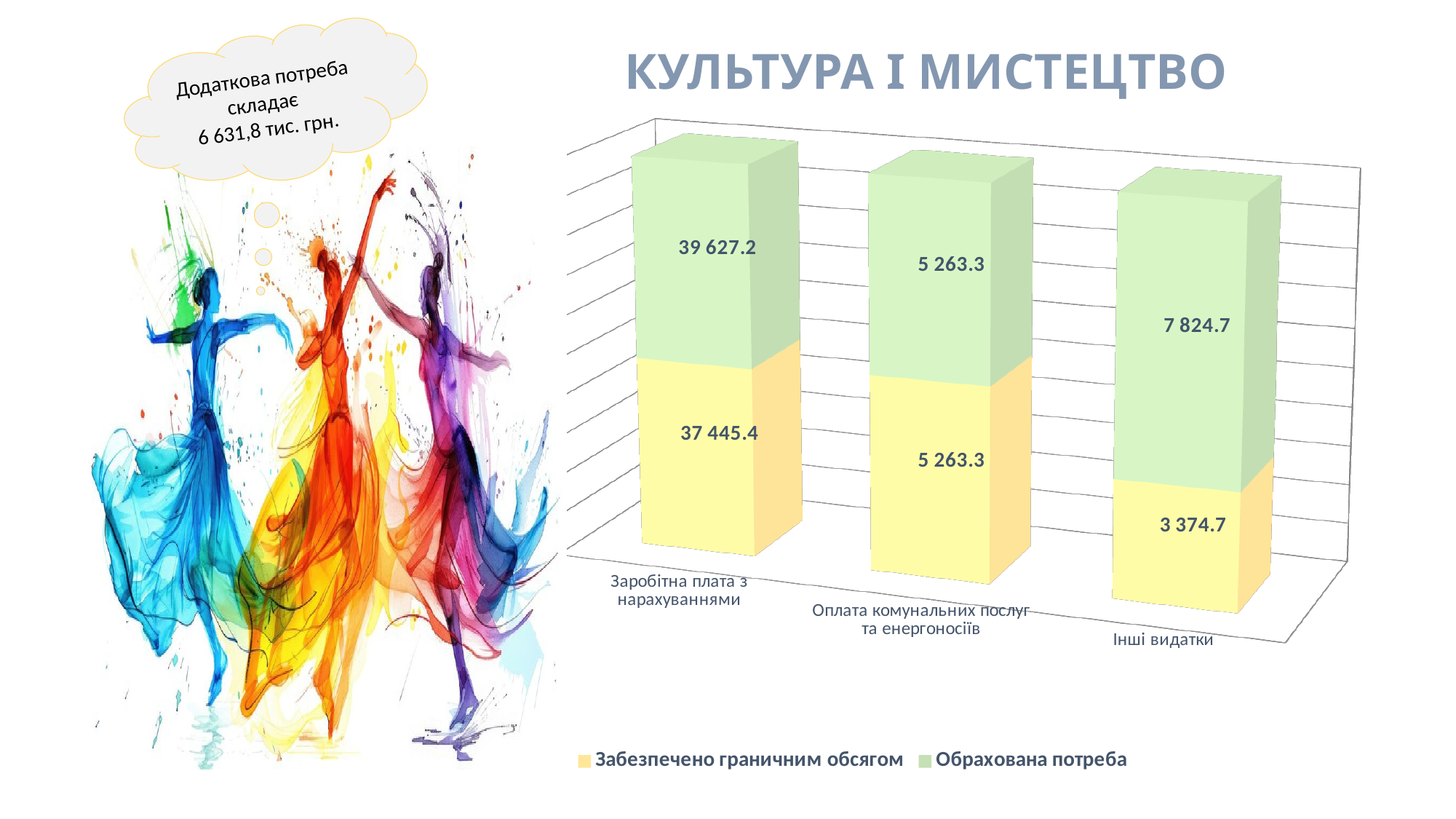
What type of chart is shown on the slide? Stacked bar chart For "Заробітна плата з нарахуваннями", which is larger: "Обрахована потреба" or "Забезпечено граничним обсягом"? Обрахована потреба What is the value of "Обрахована потреба" for "Заробітна плата з нарахуваннями"? 39 627.2 How many series does the chart legend list? 2 What is the value of "Забезпечено граничним обсягом" for "Оплата комунальних послуг та енергоносіїв"? 5 263.3 Which category has the lowest value for "Забезпечено граничним обсягом"? Інші видатки Which category has the highest value for "Обрахована потреба"? Заробітна плата з нарахуваннями What is the value of "Забезпечено граничним обсягом" for "Заробітна плата з нарахуваннями"? 37 445.4 What is the value of "Обрахована потреба" for "Інші видатки"? 7 824.7 How many categories are shown on the x axis of the chart? 3 What is the difference between "Обрахована потреба" and "Забезпечено граничним обсягом" for "Інші видатки"? 4 450.0 What is the value of "Забезпечено граничним обсягом" for "Інші видатки"? 3 374.7